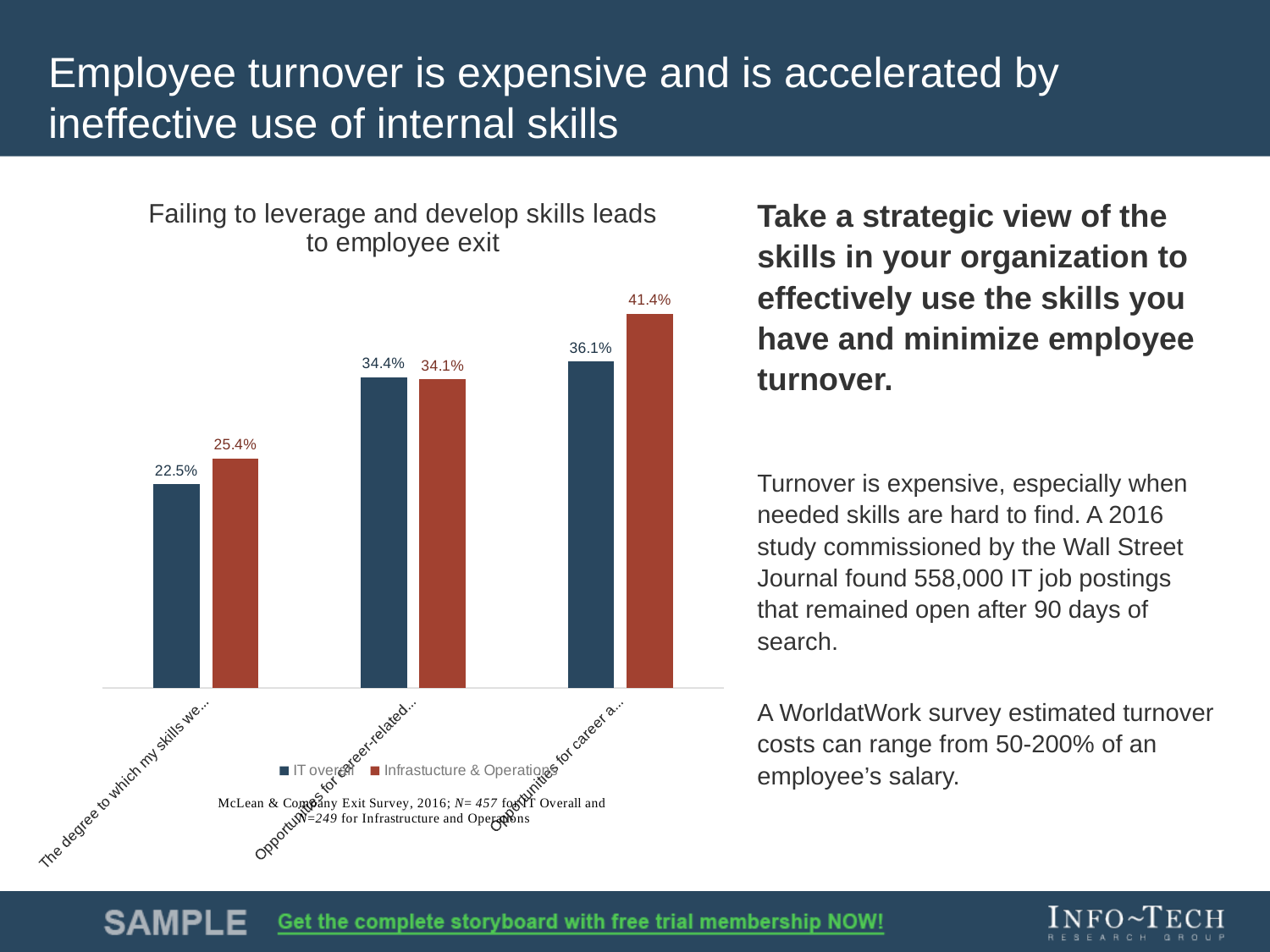
What is the difference between the Infrastucture & Operations and IT overall values in the rightmost category group? 5.3% How many series does the chart legend list? 2 What is the value of the Infrastucture & Operations bar in the leftmost category group? 25.4% Do the IT overall values rise or fall moving from the leftmost to the rightmost category group? Rise Which bar has the highest value in the chart? Infrastucture & Operations in the rightmost category group (41.4%) What kind of chart is shown on the slide? Bar chart What is the value of the Infrastucture & Operations bar in the rightmost category group? 41.4% In the leftmost category group, which series has the larger value, IT overall or Infrastucture & Operations? Infrastucture & Operations How many category groups are plotted along the x axis of the chart? 3 What is the value of the IT overall bar in the middle category group? 34.4% What is the value of the IT overall bar in the leftmost category group? 22.5% Which bar has the lowest value in the chart? IT overall in the leftmost category group (22.5%)